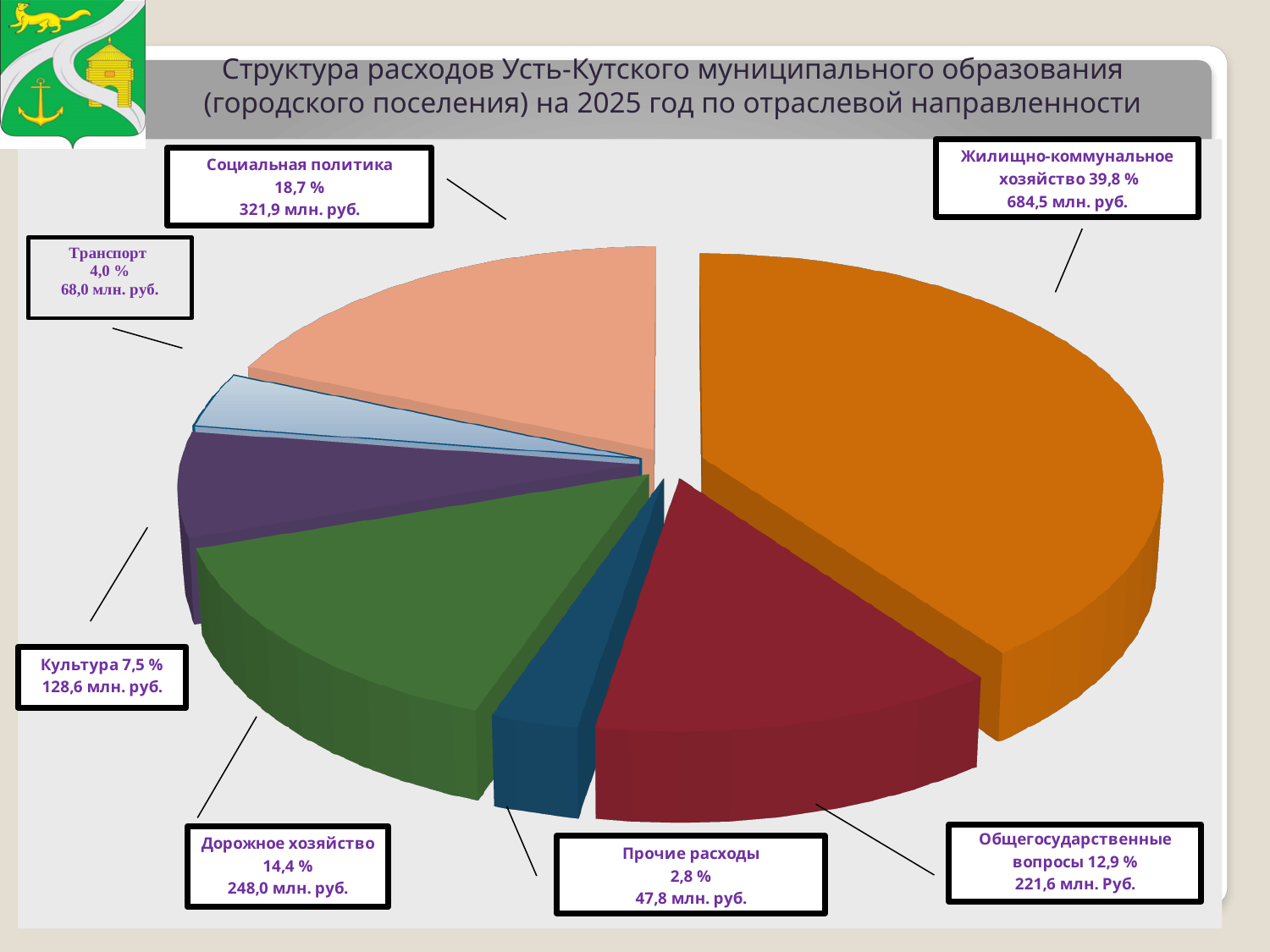
What is the difference in percentage points between the shares of Социальная политика and Дорожное хозяйство? 4,3 Which category has the largest share of expenditures? Жилищно-коммунальное хозяйство What is the amount in million rubles for Социальная политика? 321,9 млн. руб. What year does the chart title say the expenditure structure refers to? 2025 Which is larger: the share for Культура or the share for Общегосударственные вопросы? Общегосударственные вопросы Which category has the smallest share of expenditures? Прочие расходы What share of expenditures does Транспорт account for? 4,0 % What is the amount in million rubles for Прочие расходы? 47,8 млн. руб. What share of expenditures does Жилищно-коммунальное хозяйство account for? 39,8 % What type of chart is shown on the slide? Pie chart How many categories are shown in the pie chart? 7 What is the amount in million rubles for Дорожное хозяйство? 248,0 млн. руб.